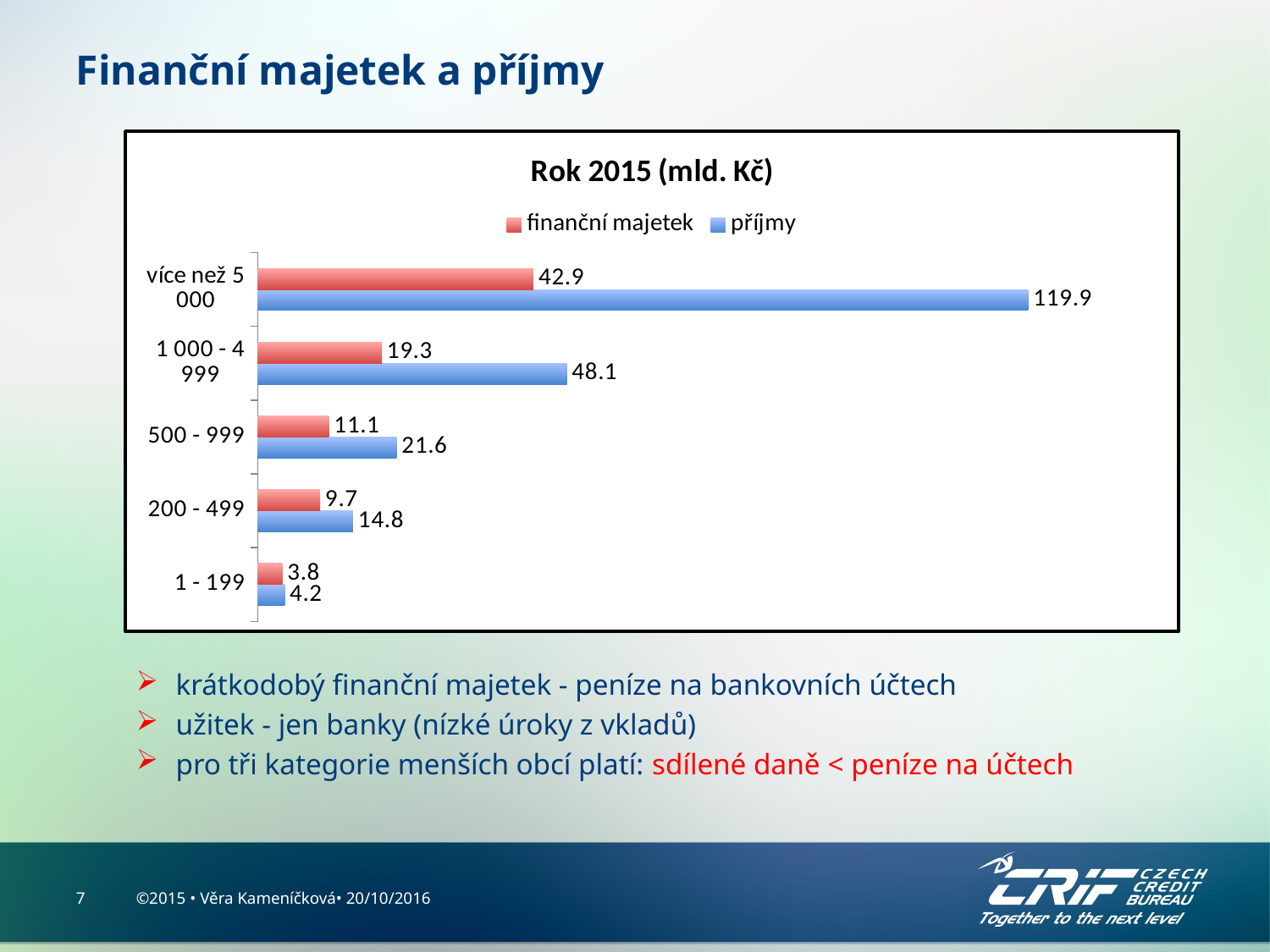
How many categories are shown on the chart? 5 What is the title of the chart? Rok 2015 (mld. Kč) What is the value of příjmy for the category 'více než 5 000'? 119.9 Which is larger for the category '200 - 499': finanční majetek or příjmy? příjmy What is the value of finanční majetek for the category '1 000 - 4 999'? 19.3 Which category has the lowest finanční majetek value? 1 - 199 Which colour represents the příjmy series? blue What kind of chart is shown on the slide? bar chart What is the difference between příjmy and finanční majetek for the category 'více než 5 000'? 77.0 What is the value of příjmy for the category '500 - 999'? 21.6 How many series does the legend list? 2 Which category has the highest příjmy value? více než 5 000